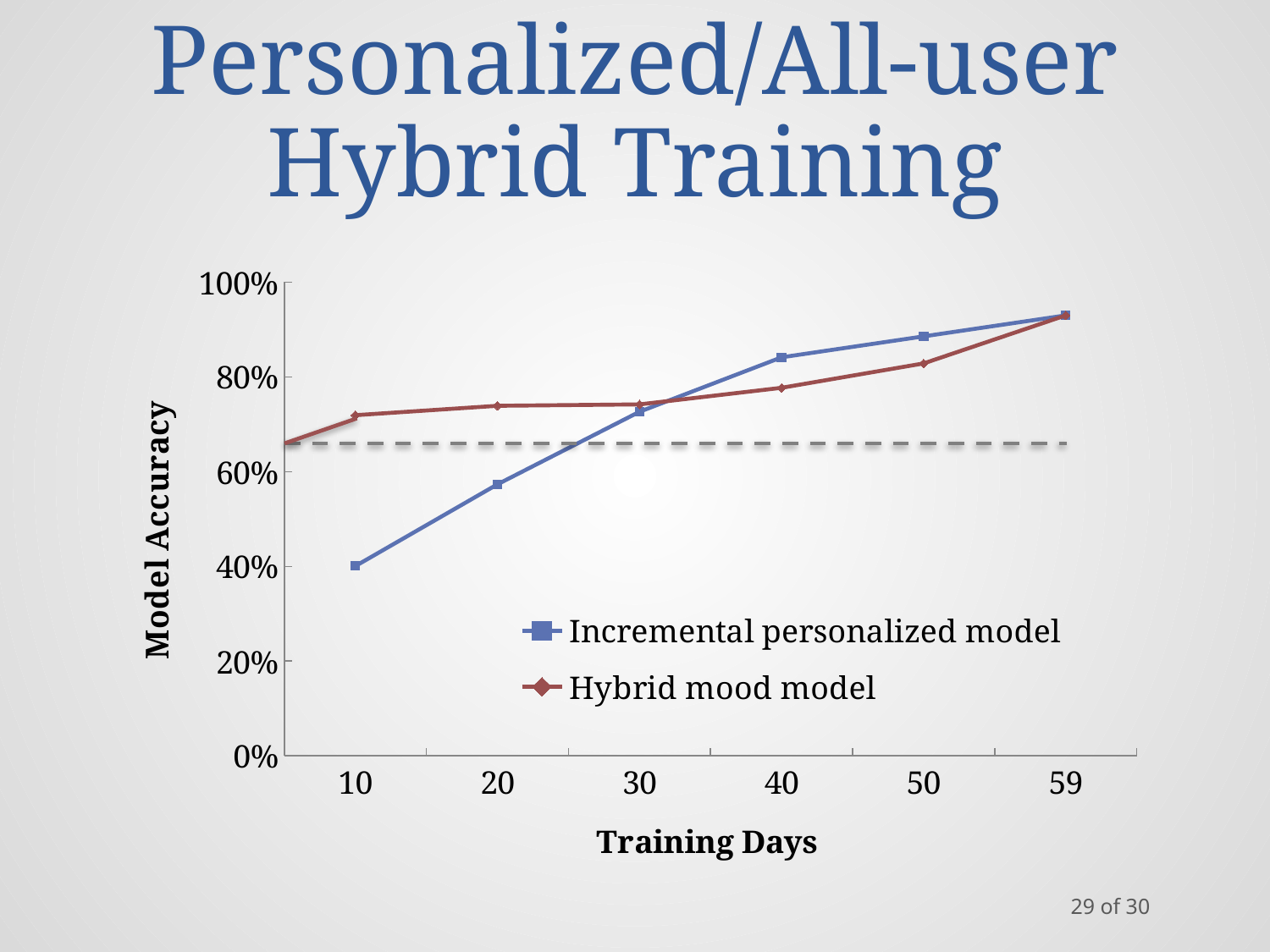
At which number of training days is the Incremental personalized model's accuracy lowest? 10 How many training-day points are plotted along the x axis? 6 Does the accuracy of the Incremental personalized model rise or fall as training days increase? rise At 10 training days, which series has the higher model accuracy? Hybrid mood model Is the value for the Hybrid mood model at 10 training days greater or less than 60%? greater Is the value for the Incremental personalized model at 40 training days greater or less than 80%? greater Is the value for the Incremental personalized model at 10 training days greater or less than 60%? less What is the title of the y axis? Model Accuracy At 40 training days, which series has the higher model accuracy? Incremental personalized model How many series does the legend list? 2 What kind of chart is shown on the slide? line chart